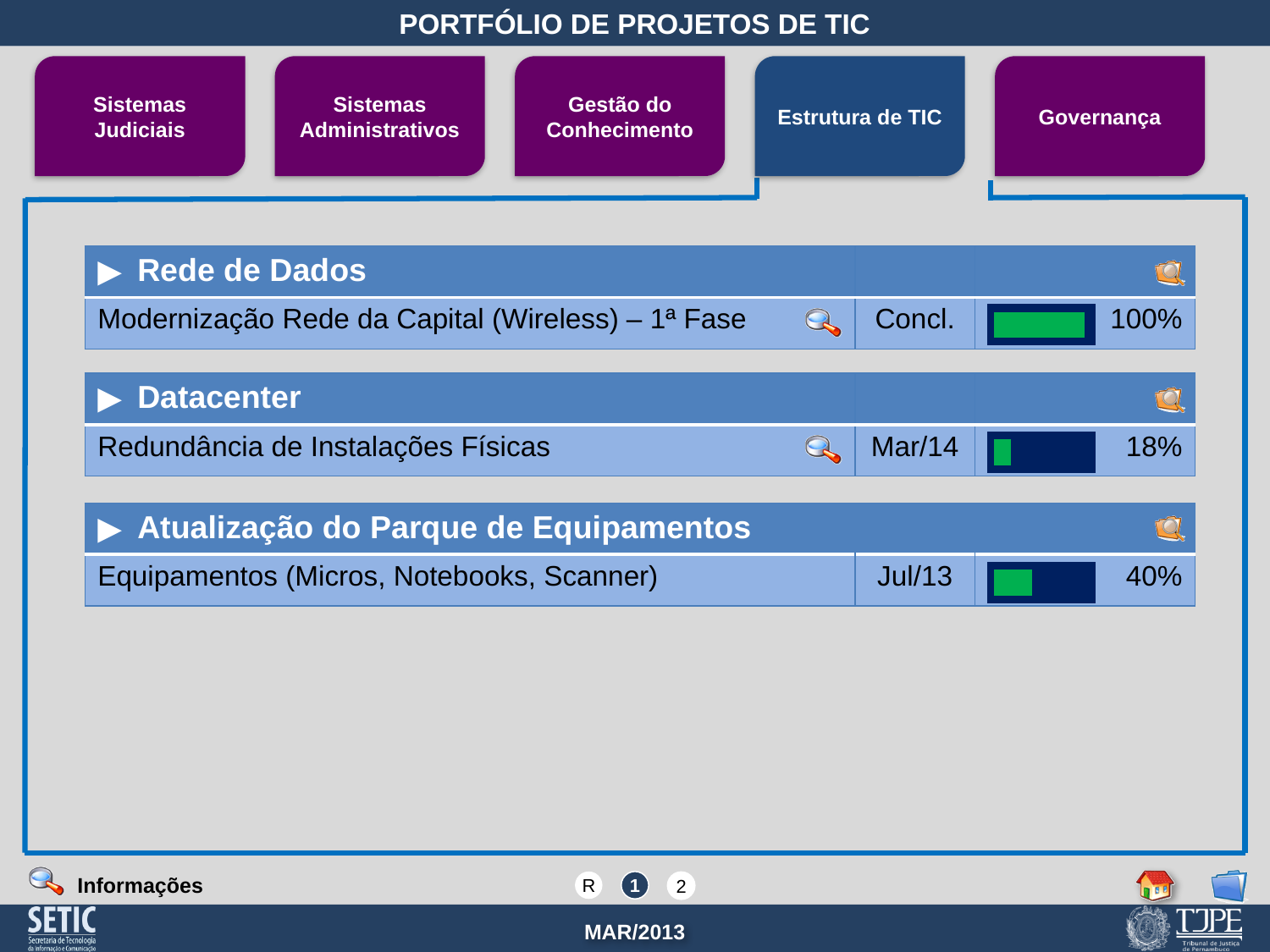
What is the difference in completion percentage between "Modernização Rede da Capital (Wireless) – 1ª Fase" and "Equipamentos (Micros, Notebooks, Scanner)"? 60% What completion percentage is shown for the project "Equipamentos (Micros, Notebooks, Scanner)"? 40% Under which section heading does the project "Equipamentos (Micros, Notebooks, Scanner)" appear? Atualização do Parque de Equipamentos What date or status is shown next to the project "Redundância de Instalações Físicas"? Mar/14 Which has a higher completion percentage: "Redundância de Instalações Físicas" or "Equipamentos (Micros, Notebooks, Scanner)"? Equipamentos (Micros, Notebooks, Scanner) What completion percentage is shown for the project "Redundância de Instalações Físicas"? 18% What is the difference in completion percentage between "Equipamentos (Micros, Notebooks, Scanner)" and "Redundância de Instalações Físicas"? 22% What completion percentage is shown for the project "Modernização Rede da Capital (Wireless) – 1ª Fase"? 100% Which project has the highest completion percentage on the slide? Modernização Rede da Capital (Wireless) – 1ª Fase What kind of chart is used to show each project's completion? Bar chart (progress bar) Which project has the lowest completion percentage on the slide? Redundância de Instalações Físicas How many projects with progress bars are shown on the slide? 3